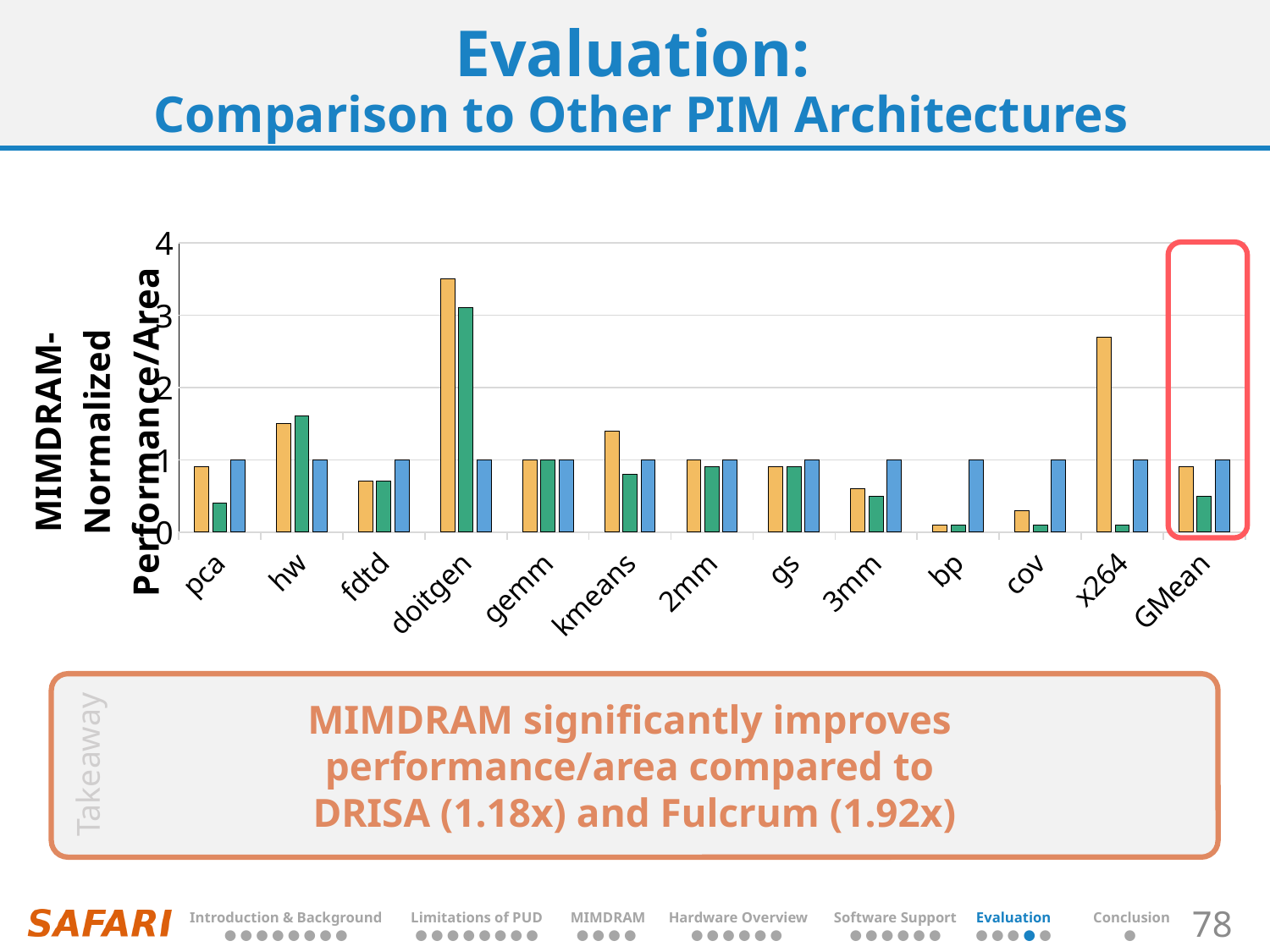
What is the value of the blue bar for GMean? 1 Is the orange bar for x264 greater or less than 2? greater How many bars are plotted for each category in the chart? 3 Which is larger, the green bar for hw or the green bar for fdtd? hw Which category on the x axis is highlighted with a red box? GMean How many categories are shown along the x axis of the chart? 13 Is the orange bar for bp greater or less than 1? less What kind of chart is shown on the slide? bar chart Is the orange bar for doitgen greater or less than 3? greater Which is larger, the orange bar for doitgen or the orange bar for x264? doitgen Which category has the tallest orange bar in the chart? doitgen